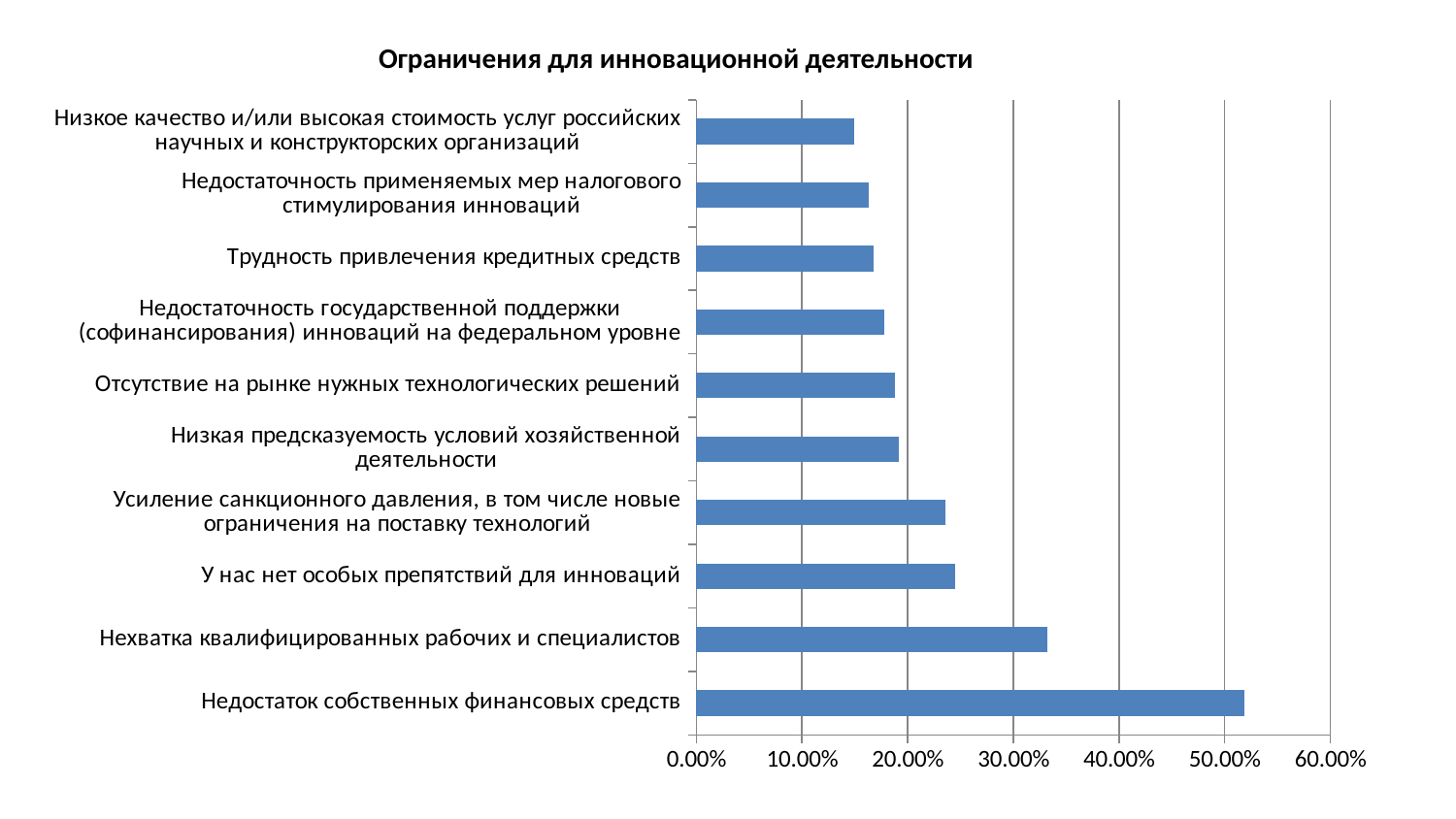
Is the value for "Недостаток собственных финансовых средств" greater or less than 50.00%? greater Is the value for "Трудность привлечения кредитных средств" greater or less than 20.00%? less Which is larger: the value for "Нехватка квалифицированных рабочих и специалистов" or for "У нас нет особых препятствий для инноваций"? Нехватка квалифицированных рабочих и специалистов Which is larger: the value for "Отсутствие на рынке нужных технологических решений" or for "Низкое качество и/или высокая стоимость услуг российских научных и конструкторских организаций"? Отсутствие на рынке нужных технологических решений What is the maximum value shown on the horizontal axis? 60.00% What kind of chart is shown on the slide? bar chart Which category has the lowest value? Низкое качество и/или высокая стоимость услуг российских научных и конструкторских организаций Which category has the highest value? Недостаток собственных финансовых средств Is the value for "Нехватка квалифицированных рабочих и специалистов" greater or less than 30.00%? greater How many categories are plotted in the chart? 10 What is the title of the chart? Ограничения для инновационной деятельности